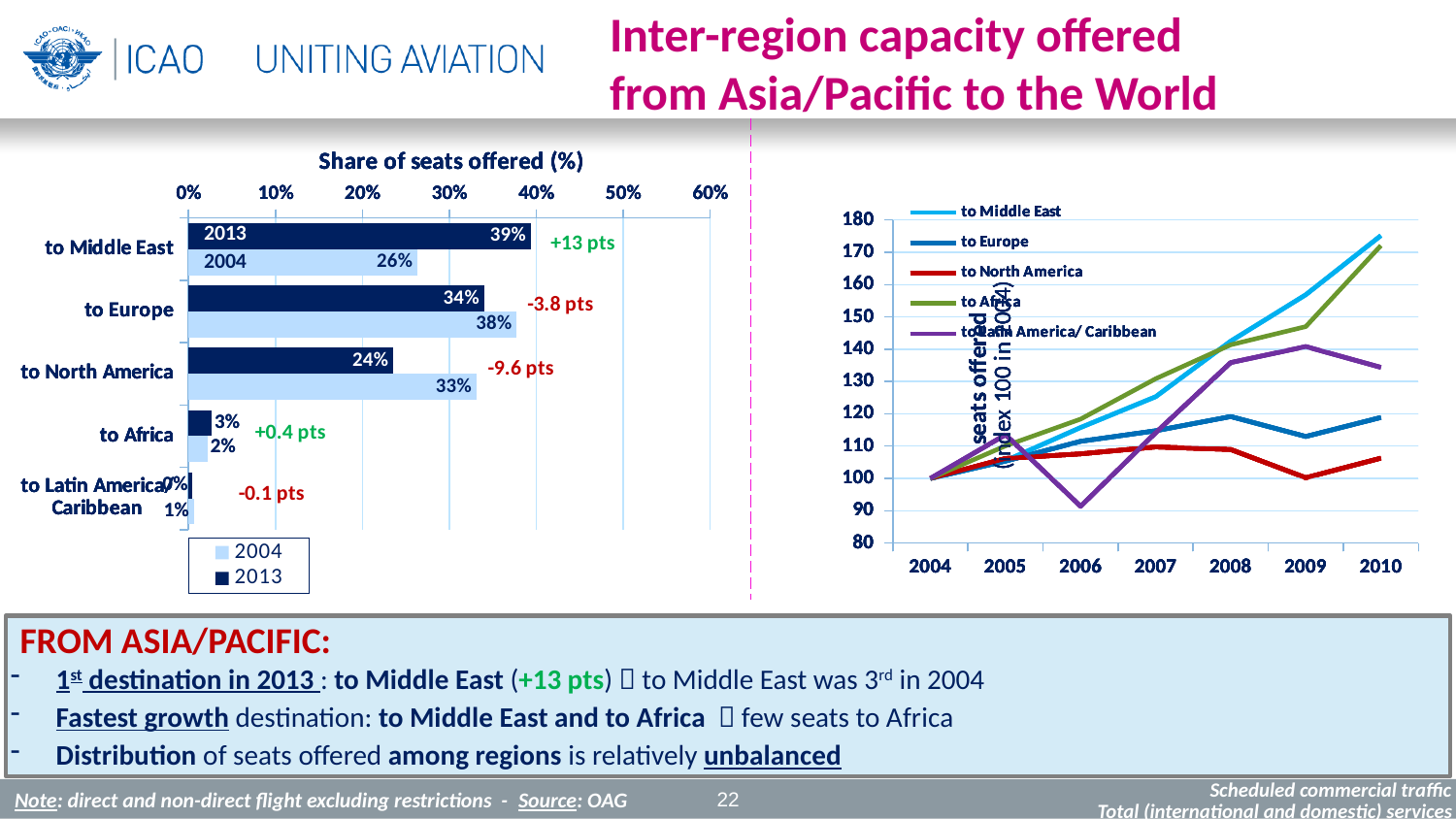
In the 'Share of seats offered (%)' bar chart, how many series does the legend list? 2 In the 'Share of seats offered (%)' bar chart, what is the 2004 share for 'to North America'? 33% What type of chart is the chart on the right of the slide? line chart In the 'Share of seats offered (%)' bar chart, what is the difference between the 2004 and 2013 shares for 'to Europe'? 3.8 pts In the 'Share of seats offered (%)' bar chart, what is the 2013 share for 'to Middle East'? 39% In the 'Share of seats offered (%)' bar chart, which destination has the highest 2013 share? to Middle East In the 'Share of seats offered (%)' bar chart, how many destination categories are shown? 5 In the 'Share of seats offered (%)' bar chart, is the 2013 share for 'to North America' larger or smaller than its 2004 share? smaller What type of chart is the chart on the left of the slide? bar chart In the line chart on the right, is the value for 'to Latin America/ Caribbean' in 2006 greater or less than 100? less In the 'Share of seats offered (%)' bar chart, which destination has the lowest 2004 share? to Latin America/ Caribbean In the line chart on the right, is the value for 'to Middle East' in 2010 greater or less than 160? greater